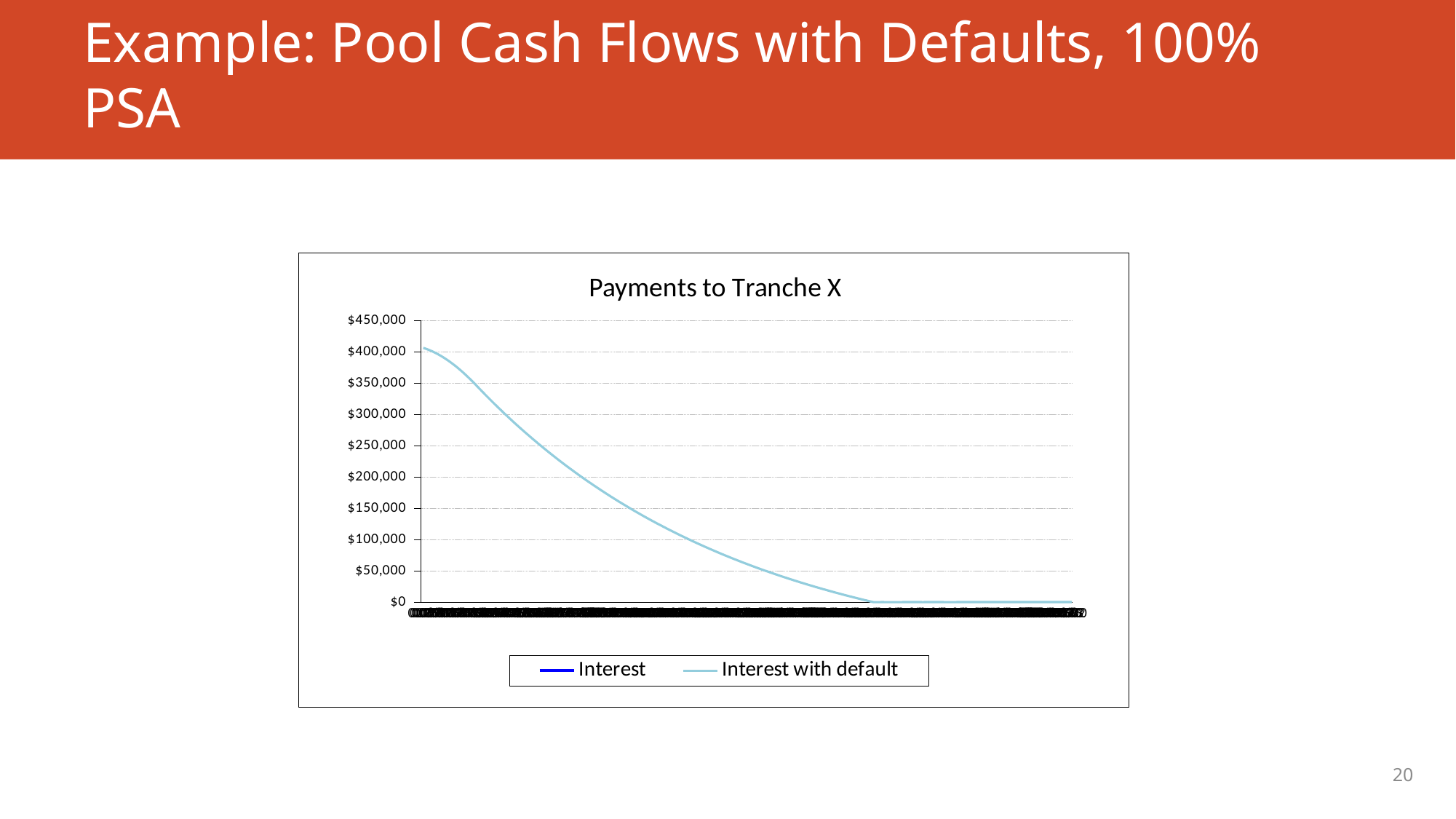
What type of chart is shown on the slide? line chart What is the highest value shown on the y axis? $450,000 Is the value of the 'Interest with default' line at the right end of the chart greater or less than $50,000? less How many series does the chart's legend list? 2 Does the 'Interest with default' line rise or fall as it moves along the x axis? fall What are the two series named in the legend? Interest; Interest with default What is the title of the chart? Payments to Tranche X Is the 'Interest with default' line at its midpoint along the x axis greater or less than $250,000? less Is the starting value of the 'Interest with default' line greater or less than $350,000? greater